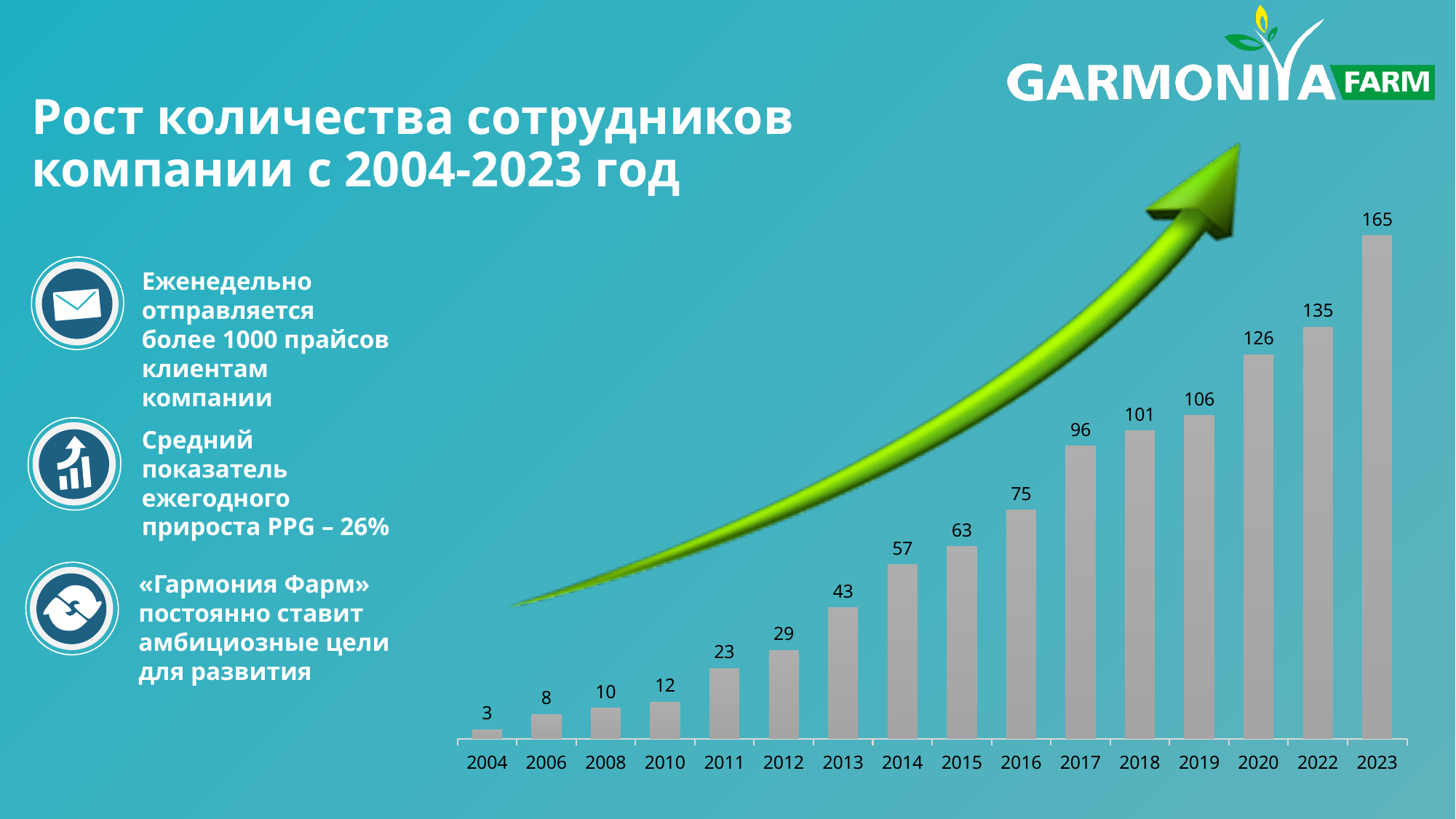
Which year has the highest value on the chart? 2023 Which year has the lowest value on the chart? 2004 What value is shown for 2004? 3 What is the title of the slide containing the chart? Рост количества сотрудников компании с 2004-2023 год What is the difference between the values for 2023 and 2022? 30 What is the difference between the values for 2016 and 2015? 12 What kind of chart is shown on the slide? bar chart Which is larger, the value for 2017 or the value for 2014? 2017 What is the number of employees shown for 2013? 43 Do the values rise or fall from 2004 to 2023? rise How many years are shown on the x axis of the chart? 16 What value is shown for 2020? 126